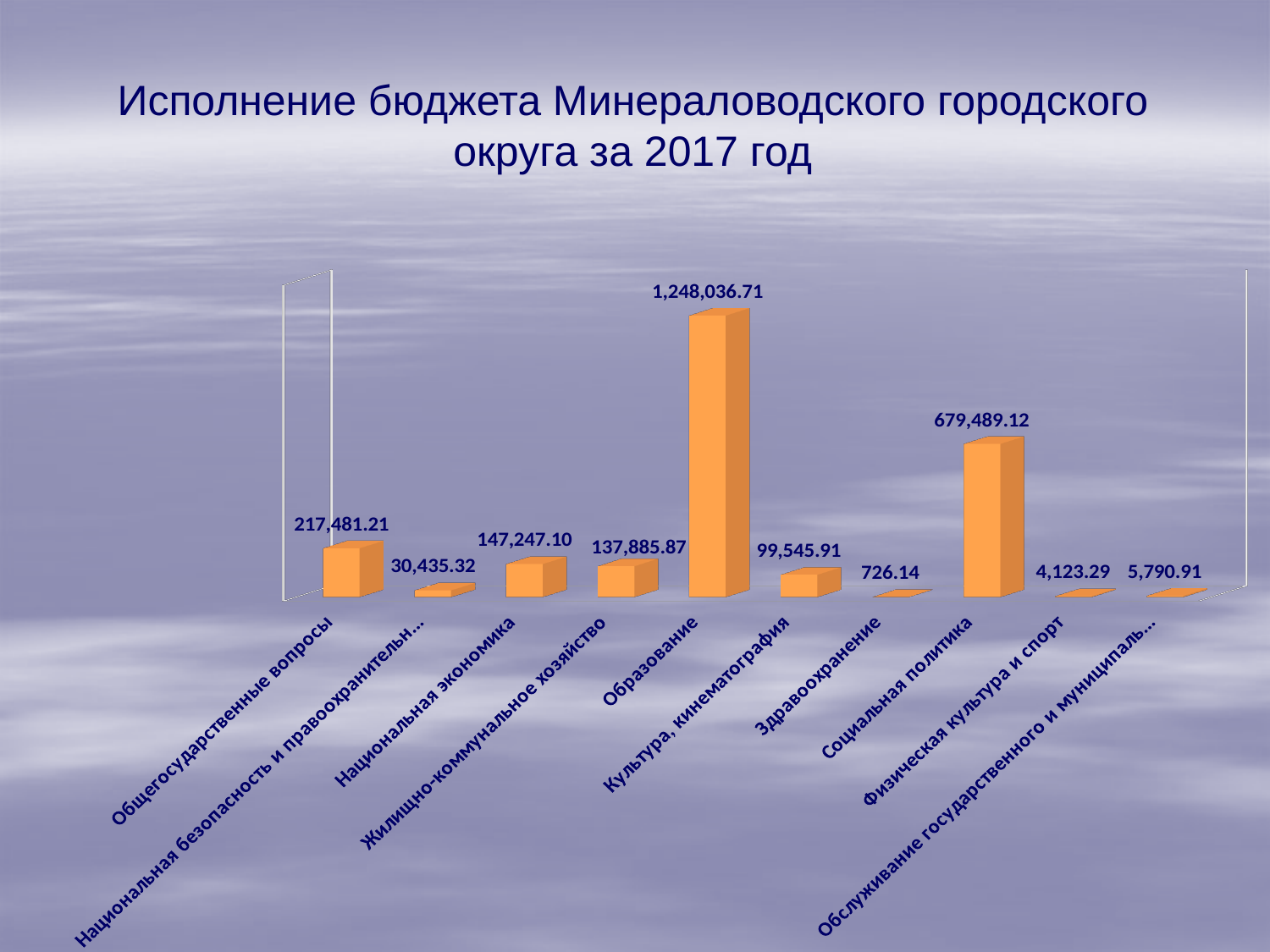
What kind of chart is shown on the slide? Bar chart What is the value for Жилищно-коммунальное хозяйство? 137,885.87 How many categories are shown in the chart? 10 What is the value for Здравоохранение? 726.14 Which is larger, the value for Общегосударственные вопросы or the value for Культура, кинематография? Общегосударственные вопросы What is the difference between the values for Образование and Социальная политика? 568,547.59 Which category has the highest value? Образование Which category has the lowest value? Здравоохранение What is the value for Социальная политика? 679,489.12 What is the value for Образование? 1,248,036.71 What is the value for Физическая культура и спорт? 4,123.29 What is the difference between the values for Национальная экономика and Жилищно-коммунальное хозяйство? 9,361.23